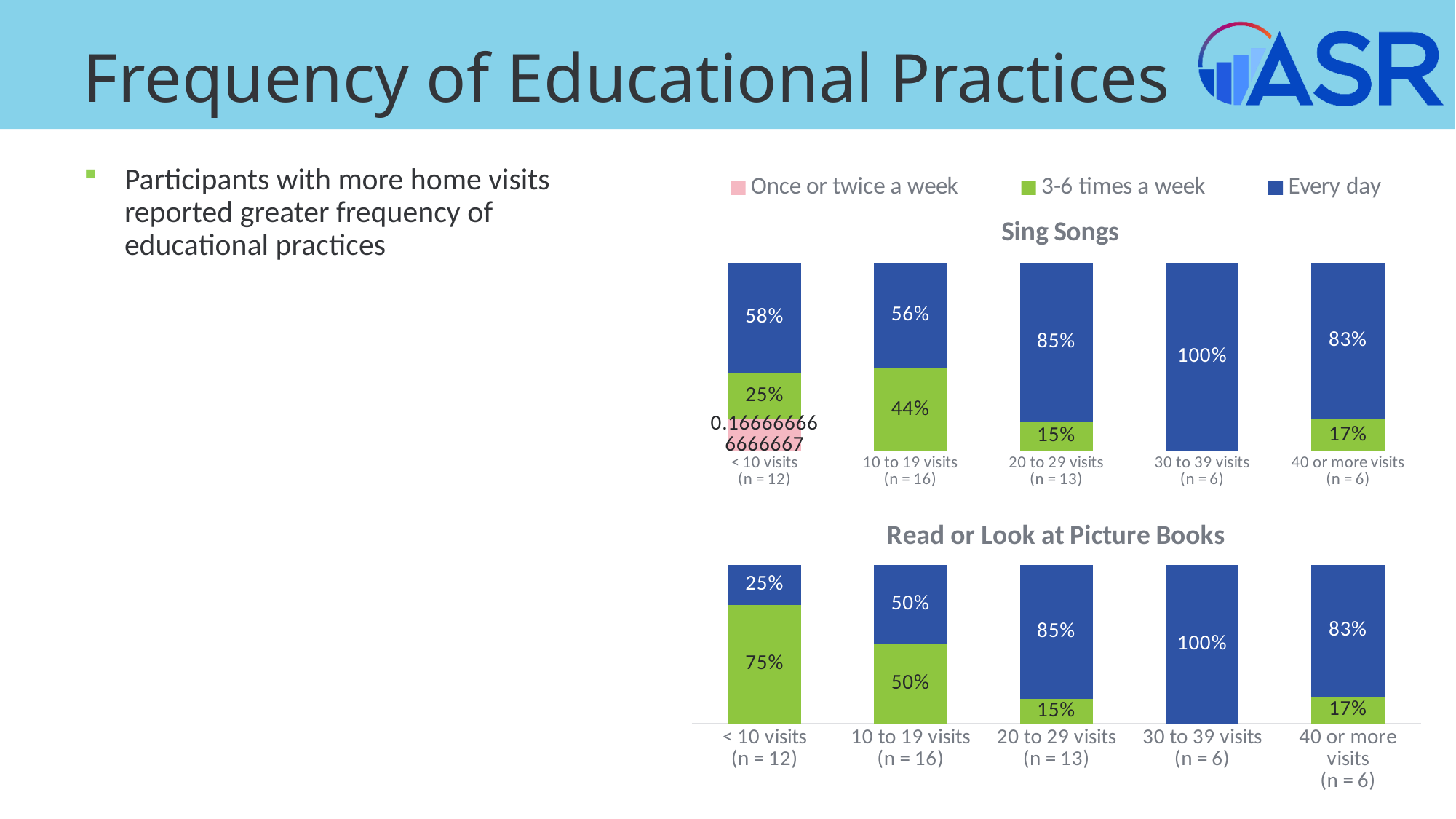
In the Read or Look at Picture Books chart, which visit group has the lowest Every day percentage? < 10 visits How many series does the legend list for the charts on this slide? 3 How many visit groups are shown on the x axis of the Read or Look at Picture Books chart? 5 Which series in the legend is shown in green? 3-6 times a week In the Sing Songs chart, what percentage of participants with 10 to 19 visits reported singing songs every day? 56% What type of chart is the Sing Songs chart? Stacked bar chart In the Read or Look at Picture Books chart, what is the Every day value for the 40 or more visits group? 83% In the Sing Songs chart, what is the 3-6 times a week value for the 20 to 29 visits group? 15% In the Sing Songs chart, which is larger for the 10 to 19 visits group: the Every day value or the 3-6 times a week value? Every day In the Read or Look at Picture Books chart, what percentage of the < 10 visits group reported reading 3-6 times a week? 75% In the Sing Songs chart, which visit group has the highest Every day percentage? 30 to 39 visits In the Read or Look at Picture Books chart, what is the difference between the Every day values for the 20 to 29 visits group and the 10 to 19 visits group? 35%